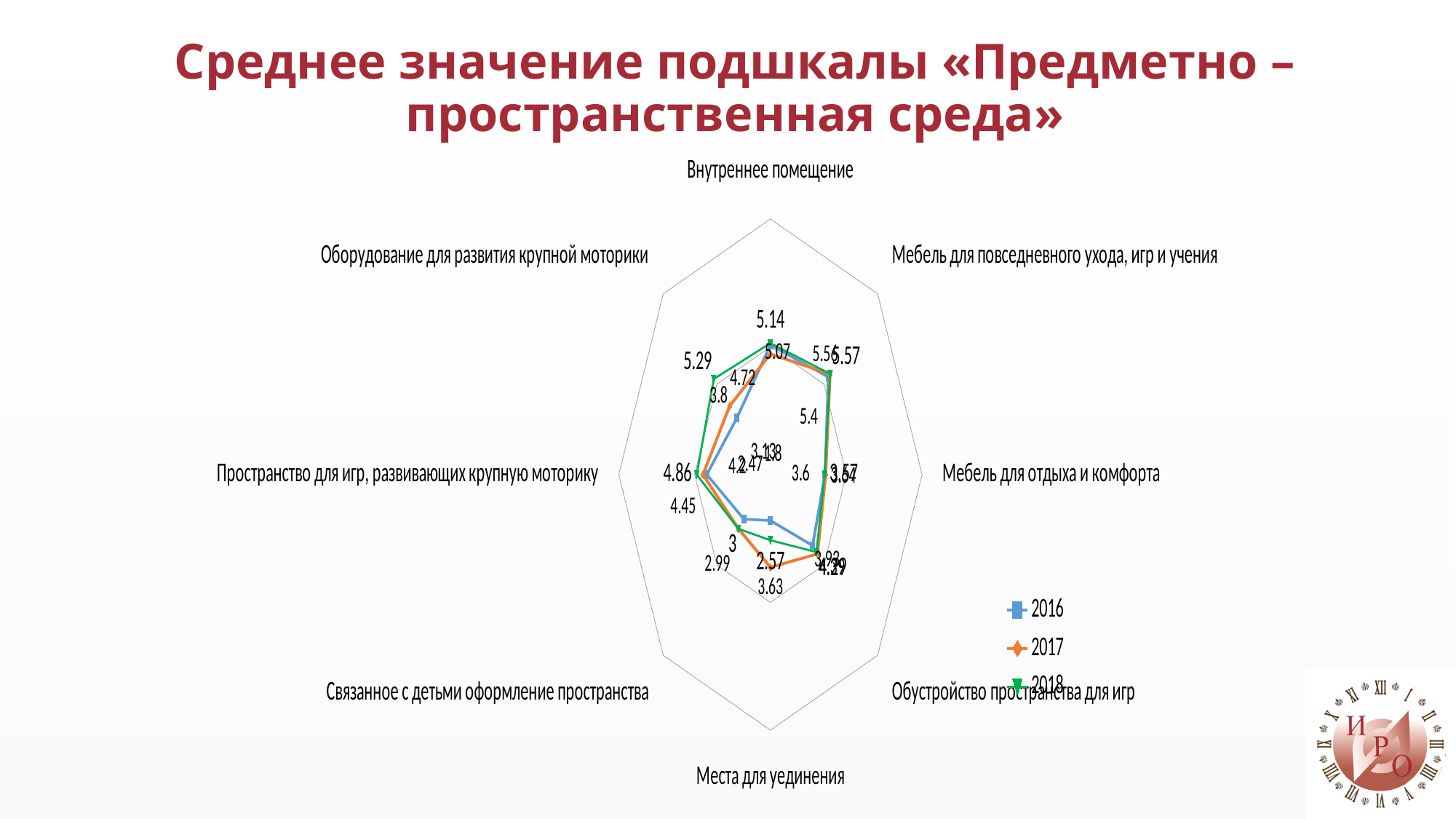
Which years are listed in the chart legend? 2016, 2017, 2018 Which category is placed at the bottom of the radar chart? Места для уединения What is the 2018 value for Пространство для игр, развивающих крупную моторику? 4.86 What kind of chart is shown on the slide? Radar chart What is the title of the slide? Среднее значение подшкалы «Предметно – пространственная среда» What is the 2018 value for Внутреннее помещение? 5.14 How many categories (axes) does the radar chart have? 8 Which category is placed at the top of the radar chart? Внутреннее помещение How many series does the legend list? 3